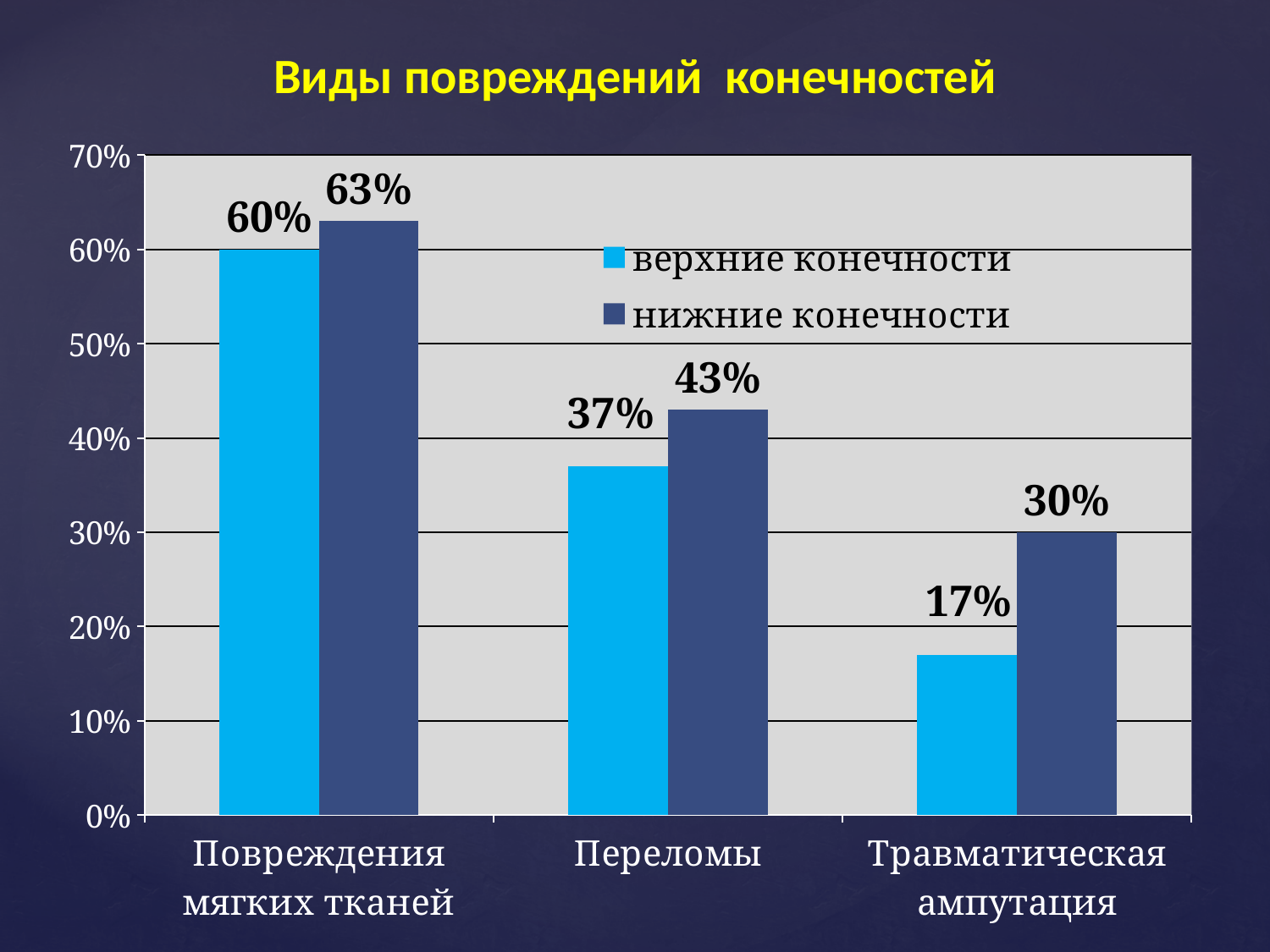
How many series does the legend list? 2 Which category has the highest value for нижние конечности? Повреждения мягких тканей What is the value for верхние конечности in the Травматическая ампутация category? 17% How many categories are shown on the x axis? 3 What is the value for верхние конечности in the Повреждения мягких тканей category? 60% What is the title of the chart? Виды повреждений конечностей What kind of chart is shown on the slide? Bar chart Do the values for верхние конечности rise or fall from left to right along the x axis? Fall Which category has the lowest value for верхние конечности? Травматическая ампутация What is the value for нижние конечности in the Переломы category? 43% Which is larger in the Переломы category: верхние конечности or нижние конечности? нижние конечности What is the difference between нижние конечности and верхние конечности in the Травматическая ампутация category? 13%